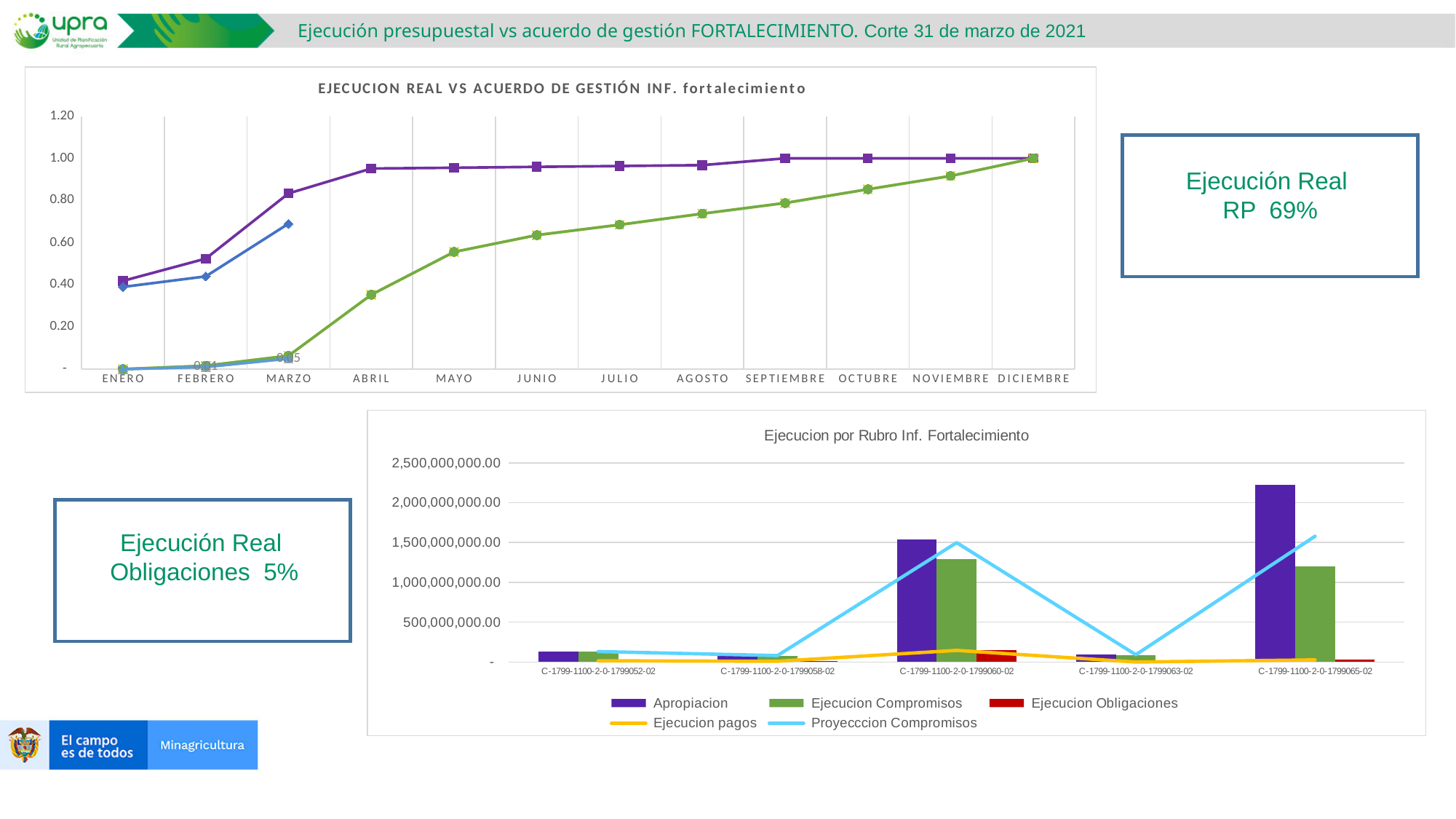
What kind of chart is the top chart 'EJECUCION REAL VS ACUERDO DE GESTIÓN INF. fortalecimiento'? Line chart In the bottom chart 'Ejecucion por Rubro Inf. Fortalecimiento', how many series does the legend list? 5 In the top chart 'EJECUCION REAL VS ACUERDO DE GESTIÓN INF. fortalecimiento', how many months are shown on the x axis? 12 In the top chart, is the value of the blue line in MARZO greater or less than 0.60? greater In the top chart, is the value of the green line in ABRIL greater or less than 0.40? less In the top chart, does the green line rise or fall from ENERO to DICIEMBRE? Rises In the top chart, what value does the purple line reach in DICIEMBRE? 1.00 In the bottom chart 'Ejecucion por Rubro Inf. Fortalecimiento', how many rubro categories are shown on the x axis? 5 In the bottom chart, for C-1799-1100-2-0-1799060-02, which is larger: Apropiacion or Ejecucion Compromisos? Apropiacion In the bottom chart, is the Apropiacion value for C-1799-1100-2-0-1799065-02 greater or less than 2,000,000,000.00? greater In the bottom chart, which category has the highest Apropiacion bar? C-1799-1100-2-0-1799065-02